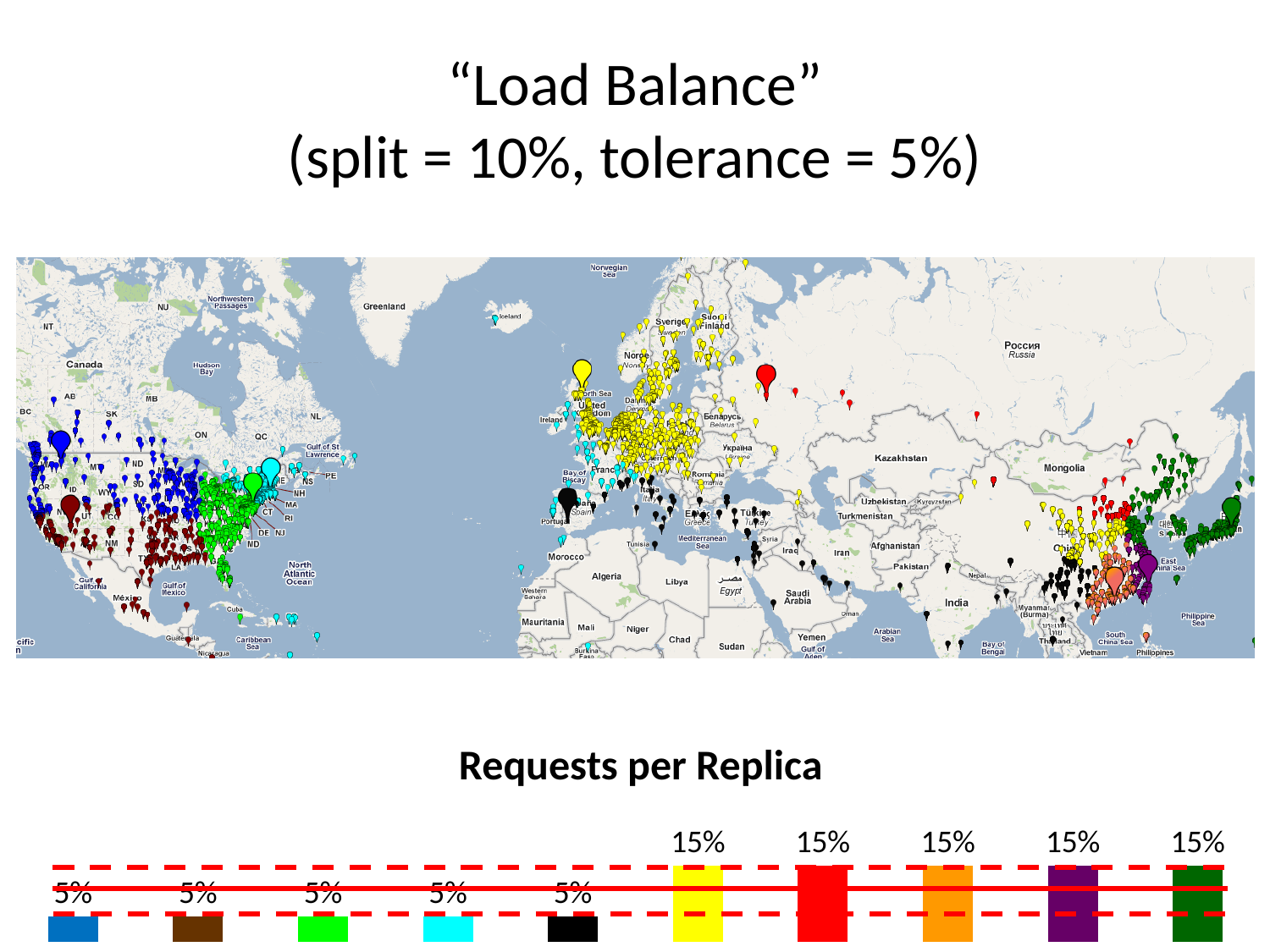
In the "Requests per Replica" chart, what value is labelled on the black bar? 5% In the "Requests per Replica" chart, what value is labelled on the blue bar? 5% In the "Requests per Replica" chart, how many bars are labelled 5%? 5 How many bars are shown in the "Requests per Replica" chart? 10 In the "Requests per Replica" chart, what value is labelled on the purple bar? 15% What kind of chart is shown under the heading "Requests per Replica"? bar chart What is the split and tolerance stated in the slide title? split = 10%, tolerance = 5% In the "Requests per Replica" chart, how many bars are labelled 15%? 5 In the "Requests per Replica" chart, what is the difference between the yellow bar's value and the cyan bar's value? 10% In the "Requests per Replica" chart, which bar is larger, the orange bar or the brown bar? orange bar What is the title of the bar chart at the bottom of the slide? Requests per Replica In the "Requests per Replica" chart, what value is labelled on the red bar? 15%